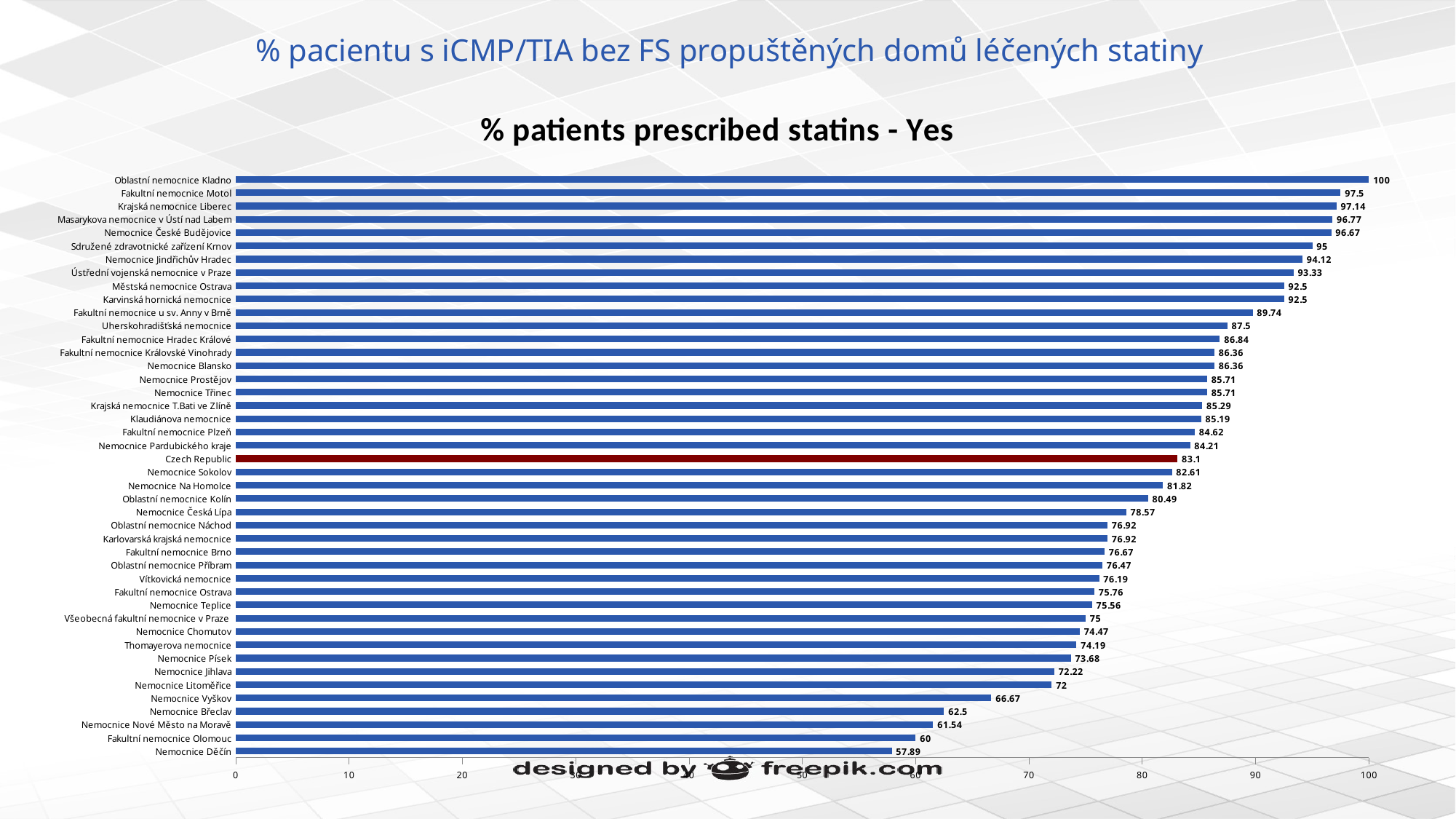
What is the value for Nemocnice Děčín? 57.89 Which hospital has the lowest value? Nemocnice Děčín What kind of chart is shown on the slide? bar chart Which bar is coloured differently (dark red) from the others? Czech Republic Is the value for Nemocnice Vyškov greater or less than 70? less Which hospital has the highest value? Oblastní nemocnice Kladno What is the value for Oblastní nemocnice Kladno? 100 How many bars are shown in the chart? 44 What is the difference between the values for Fakultní nemocnice Motol and Nemocnice Břeclav? 35 What is the value for Czech Republic? 83.1 Which has a larger value, Nemocnice Sokolov or Nemocnice Teplice? Nemocnice Sokolov What is the value for Fakultní nemocnice Olomouc? 60